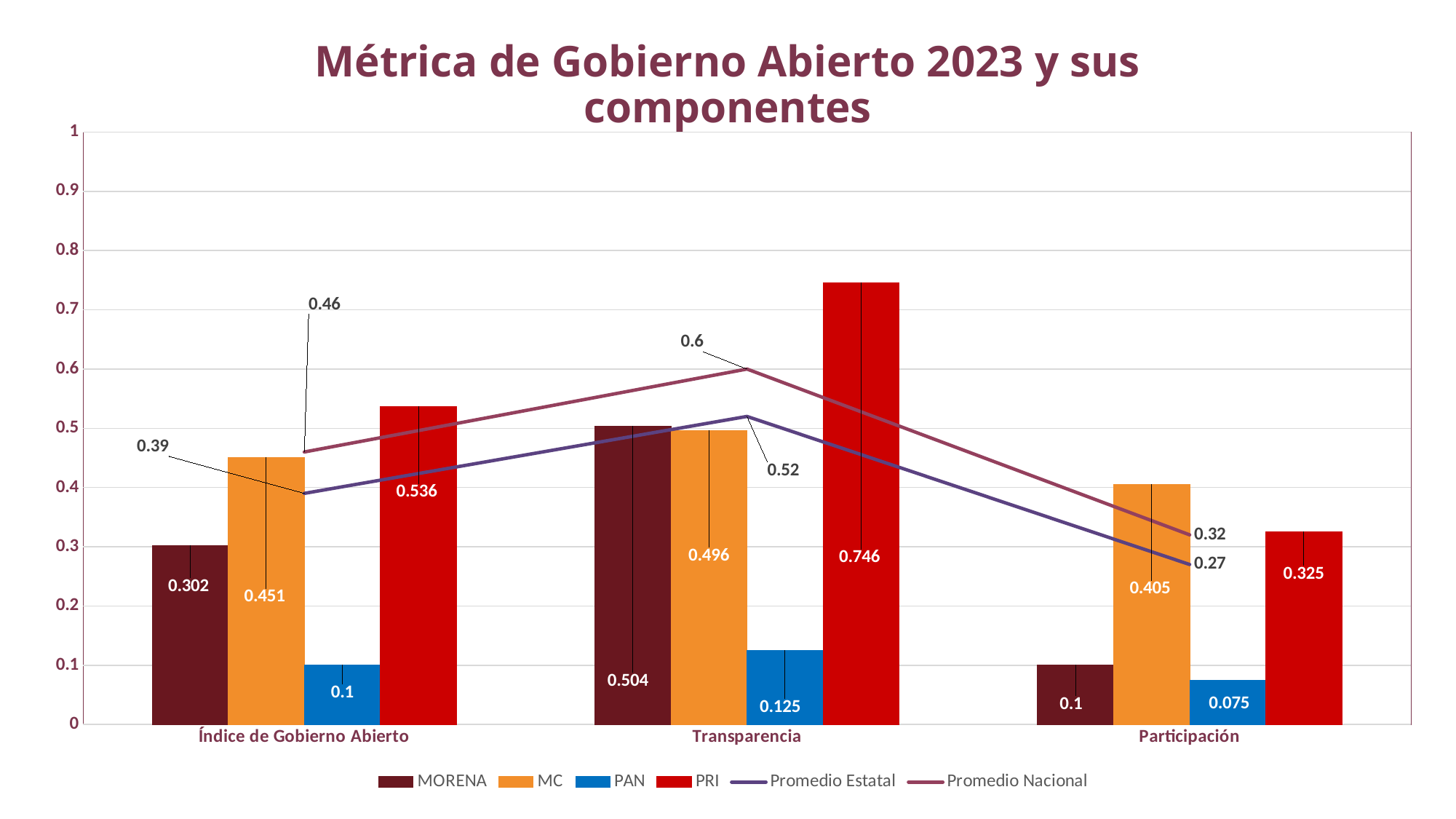
What is the title of the chart? Métrica de Gobierno Abierto 2023 y sus componentes What is the difference between the PRI and MORENA values in the Índice de Gobierno Abierto category? 0.234 Which party has the lowest value in the Participación category? PAN What is the Promedio Nacional value for Transparencia? 0.6 Which party has the highest value in the Transparencia category? PRI What kind of chart is this? Combined bar and line chart How many series does the legend list? 6 How many categories are shown on the x axis? 3 What is the Promedio Estatal value for Participación? 0.27 What is the value for PRI in the Transparencia category? 0.746 Which is larger in the Participación category, the MC value or the PRI value? MC What is the value for MC in the Índice de Gobierno Abierto category? 0.451